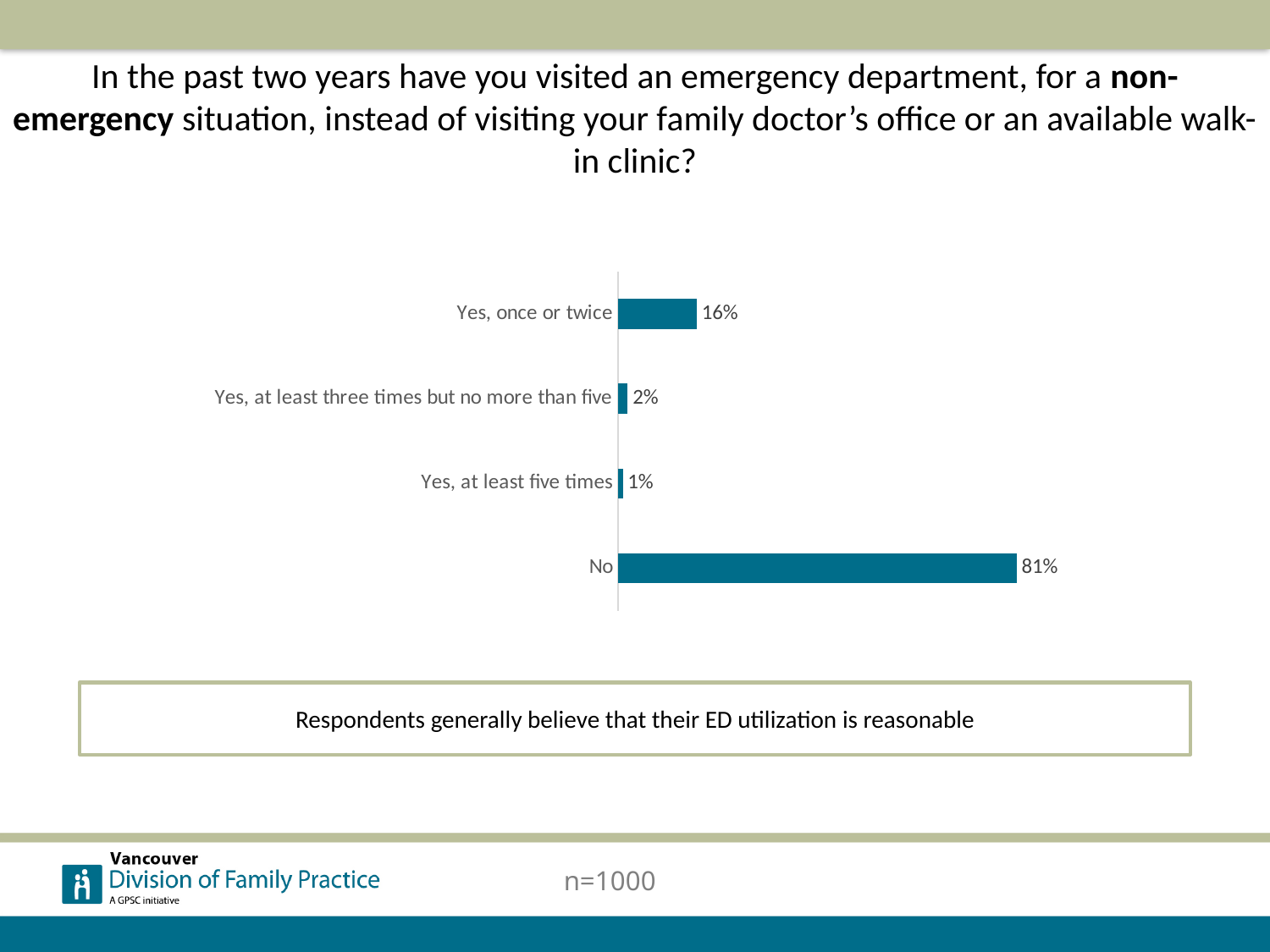
What is the sample size (n) shown on the slide? n=1000 Which response category has the highest percentage? No Which response category has the lowest percentage? Yes, at least five times What kind of chart is shown on the slide? Bar chart Which is larger: the percentage for "Yes, once or twice" or for "Yes, at least three times but no more than five"? Yes, once or twice What percentage of respondents answered "Yes, once or twice"? 16% How many response categories are shown in the chart? 4 What percentage of respondents answered "Yes, at least three times but no more than five"? 2% What percentage of respondents answered "Yes, at least five times"? 1% What is the combined percentage of all three "Yes" responses? 19% What percentage of respondents answered "No"? 81% What is the difference in percentage points between "No" and "Yes, once or twice"? 65